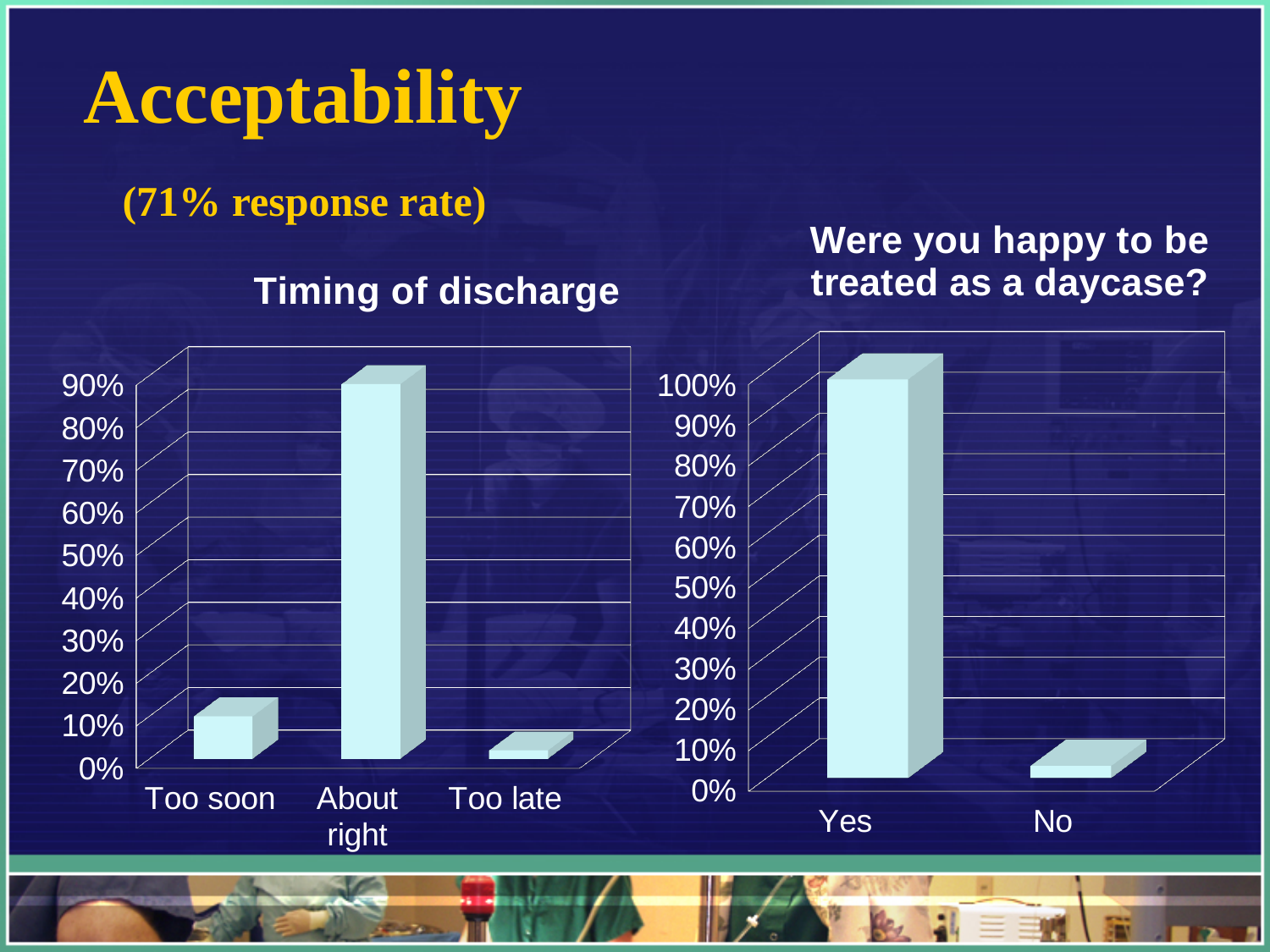
In the "Were you happy to be treated as a daycase?" chart, is the value for "No" greater or less than 10%? less What is the title of the chart on the right of the slide? Were you happy to be treated as a daycase? In the "Timing of discharge" chart, which is larger, the value for "Too soon" or the value for "Too late"? Too soon In the "Timing of discharge" chart, which category has the highest value? About right In the "Timing of discharge" chart, is the value for "Too soon" greater or less than 20%? less How many categories does the "Timing of discharge" chart show? 3 In the "Timing of discharge" chart, which category has the lowest value? Too late In the "Were you happy to be treated as a daycase?" chart, which category has the highest value? Yes What kind of chart is the "Timing of discharge" chart? bar chart How many categories does the "Were you happy to be treated as a daycase?" chart show? 2 In the "Timing of discharge" chart, is the value for "About right" greater or less than 80%? greater